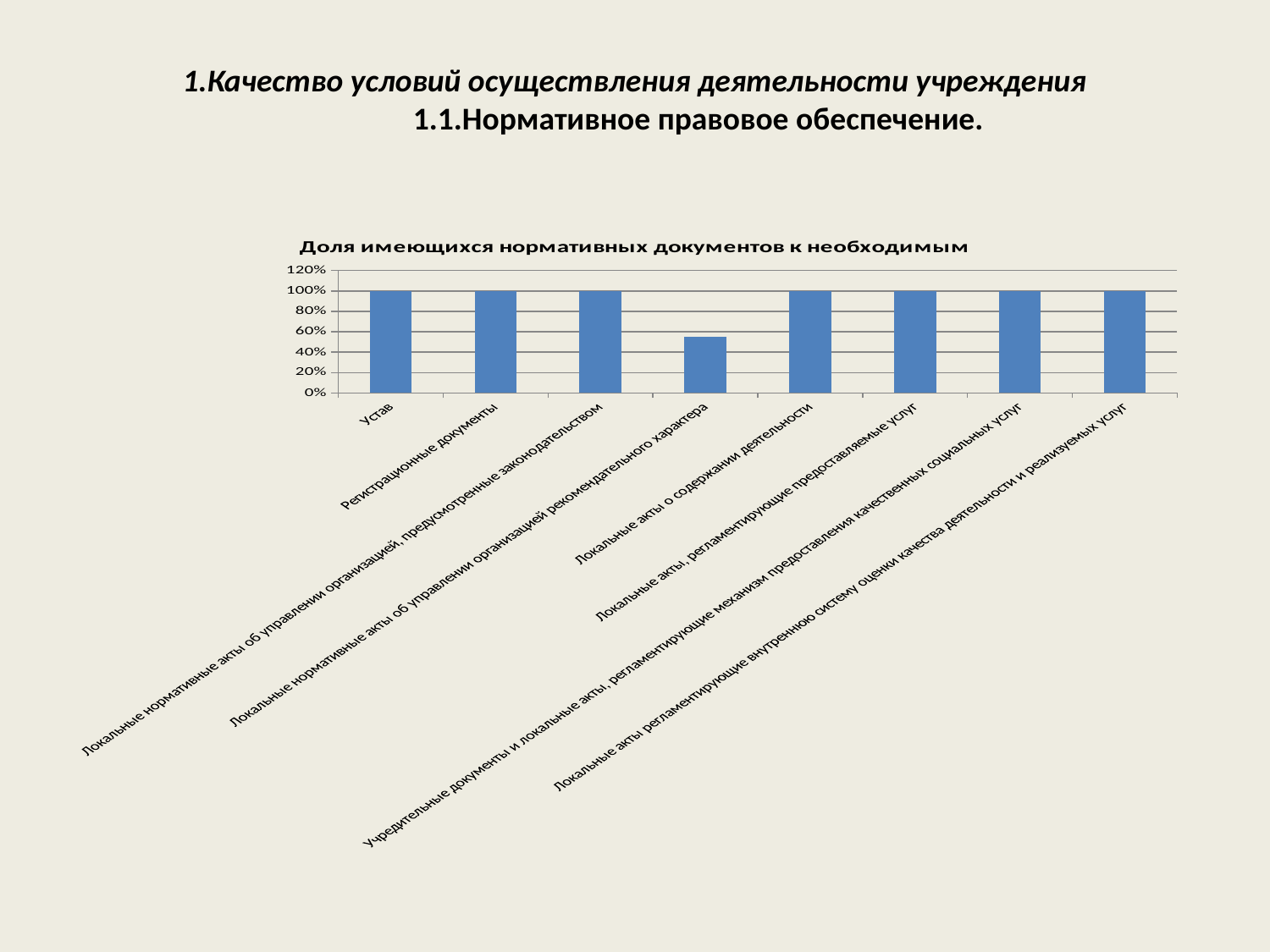
Which is larger: the value for Устав or the value for Локальные нормативные акты об управлении организацией рекомендательного характера? Устав How many categories have a value of 100%? 7 What is the title of the chart? Доля имеющихся нормативных документов к необходимым What is the value for Устав? 100% Is the value for Локальные нормативные акты об управлении организацией рекомендательного характера greater or less than 80%? less Is the value for Локальные нормативные акты об управлении организацией рекомендательного характера greater or less than 40%? greater Which category has the lowest value? Локальные нормативные акты об управлении организацией рекомендательного характера What is the value for Локальные акты о содержании деятельности? 100% How many categories are plotted in the chart? 8 What is the value for Регистрационные документы? 100% What type of chart is shown on the slide? Bar chart What is the highest tick shown on the vertical axis? 120%